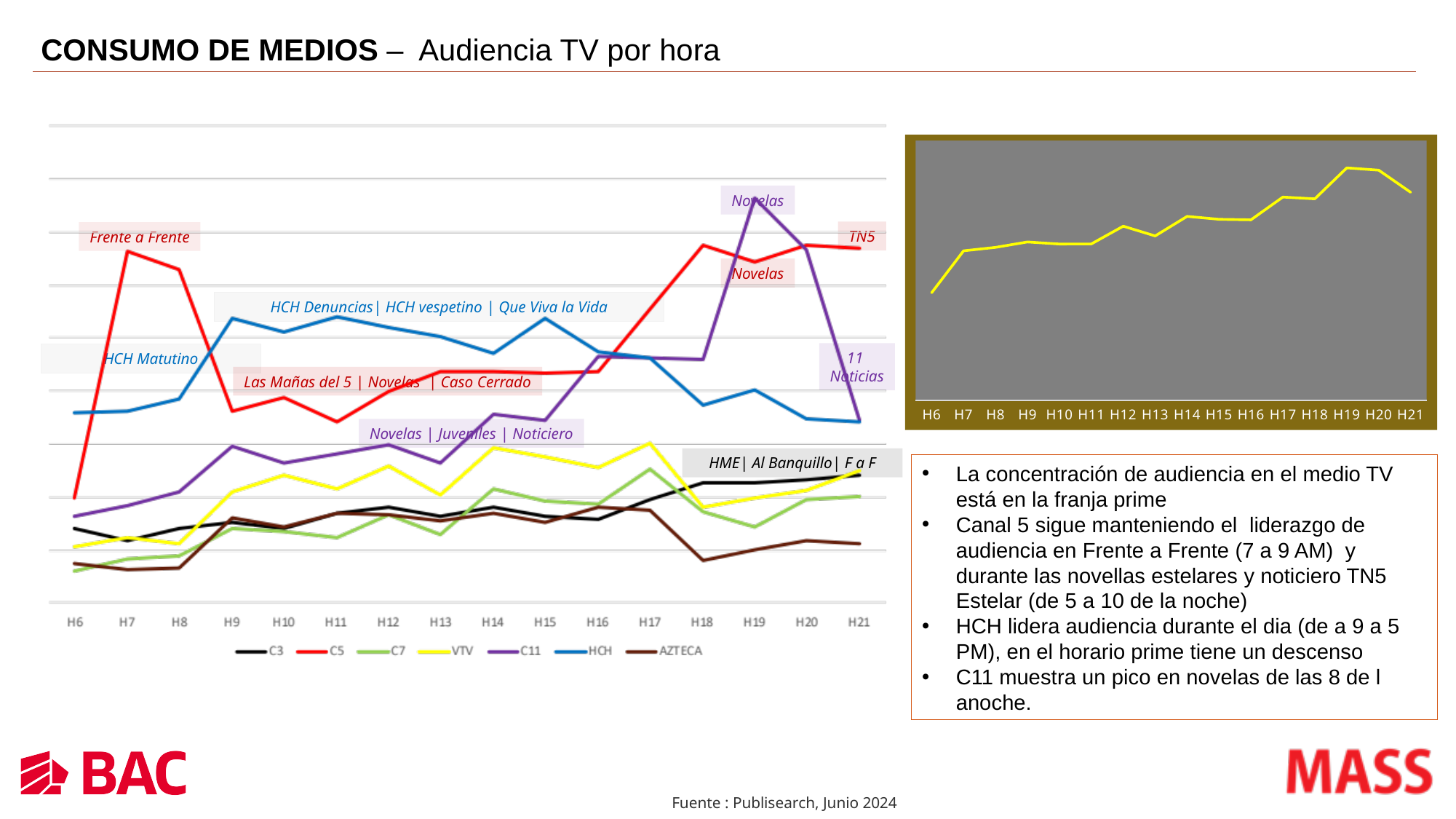
In the left chart, at which hour is C5 at its lowest? H6 In the left chart, which series has the highest value at H7? C5 How many series does the legend of the left chart list? 7 What kind of chart is the large chart on the left of the slide? line chart In the left chart, at which hour does C11 reach its peak? H19 In the small chart on the right, at which hour does the line reach its highest point? H19 In the small chart on the right, does the line generally rise or fall from H6 to H19? rise In the left chart, which is higher at H12, HCH or C5? HCH In the left chart, which is higher at H21, C5 or C11? C5 In the left chart, which series has the lowest value at H18? AZTECA How many hour categories are shown on the x axis of the left chart? 16